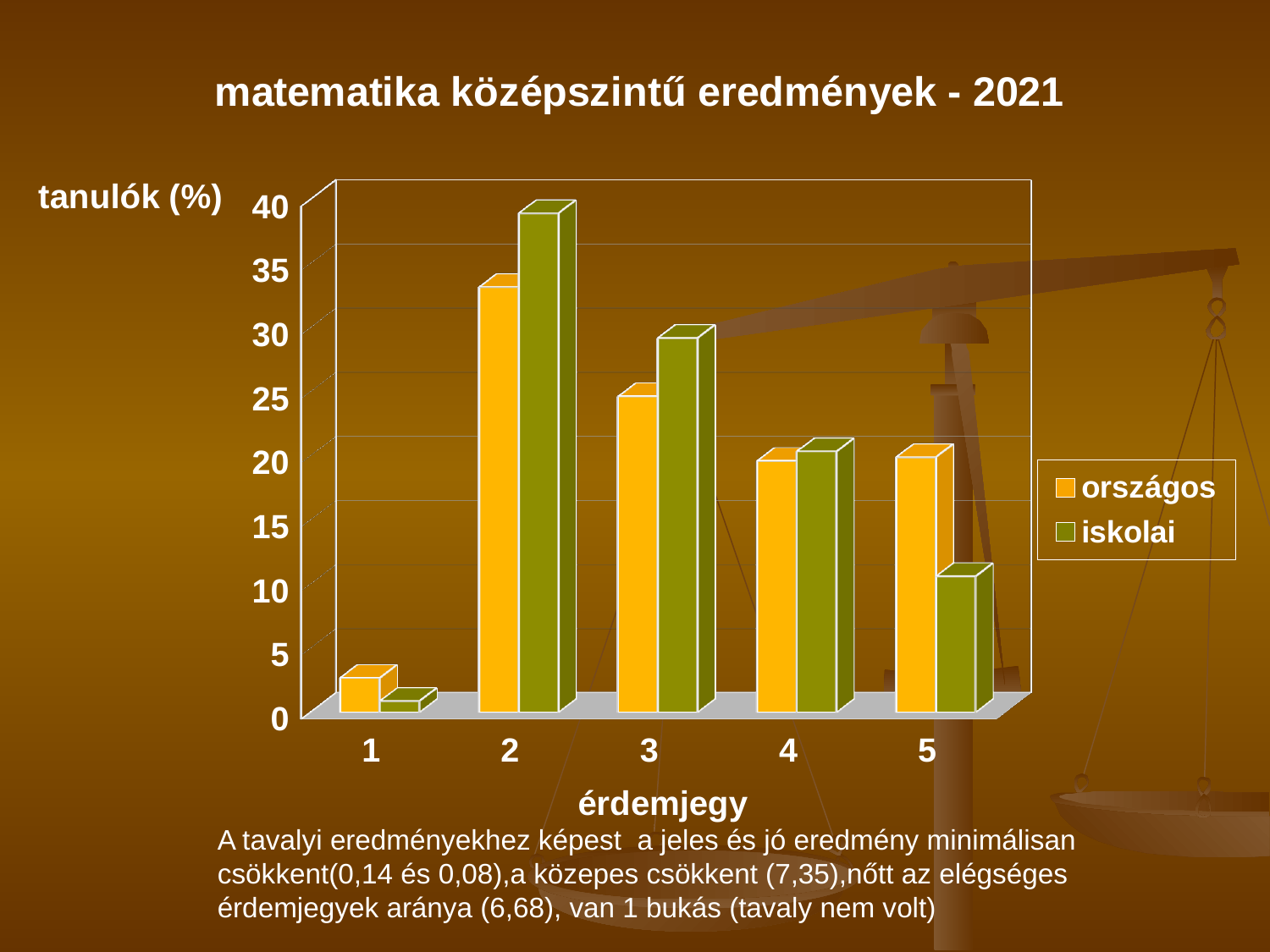
What is the title of the chart? matematika középszintű eredmények - 2021 What kind of chart is shown on the slide? bar chart Is the iskolai value for érdemjegy 2 greater or less than 35? greater Which érdemjegy has the highest iskolai value? 2 How many series does the legend list? 2 What are the two series named in the legend? országos and iskolai For érdemjegy 2, which is larger: országos or iskolai? iskolai Which érdemjegy has the lowest országos value? 1 Is the országos value for érdemjegy 1 greater or less than 5? less Is the iskolai value for érdemjegy 5 greater or less than 15? less How many categories (érdemjegy values) are shown on the x axis? 5 For érdemjegy 5, which is larger: országos or iskolai? országos